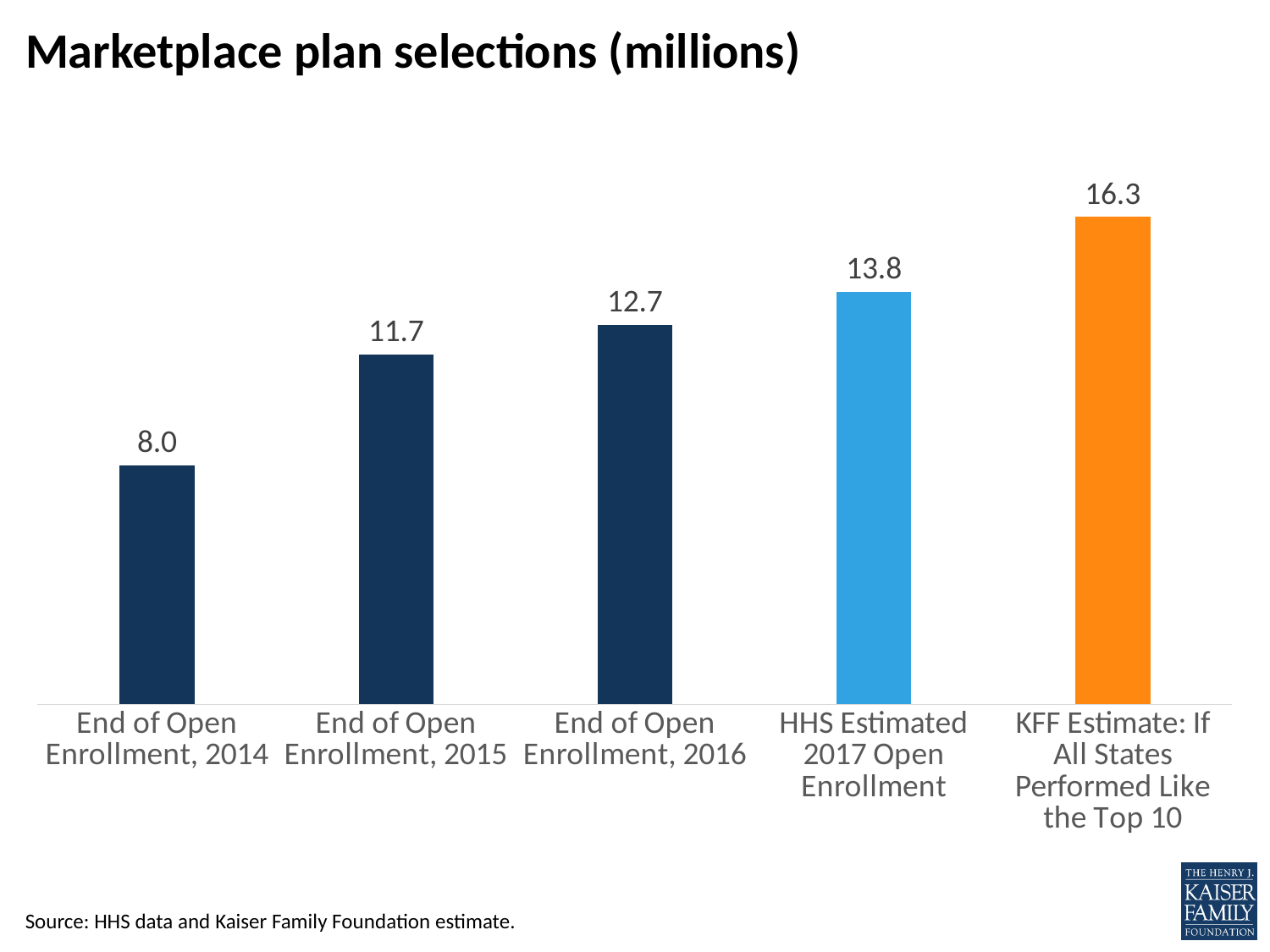
What is the difference between the KFF Estimate and the HHS Estimated 2017 Open Enrollment? 2.5 Do the values rise or fall from left to right across the categories? Rise How many categories are shown in the chart? 5 Which category has the highest value? KFF Estimate: If All States Performed Like the Top 10 Which category has the lowest value? End of Open Enrollment, 2014 What kind of chart is this? Bar chart What is the value for KFF Estimate: If All States Performed Like the Top 10? 16.3 What is the difference between End of Open Enrollment, 2015 and End of Open Enrollment, 2014? 3.7 What is the value for HHS Estimated 2017 Open Enrollment? 13.8 What is the value for End of Open Enrollment, 2016? 12.7 What is the value for End of Open Enrollment, 2014? 8.0 Which is larger, End of Open Enrollment, 2016 or End of Open Enrollment, 2015? End of Open Enrollment, 2016